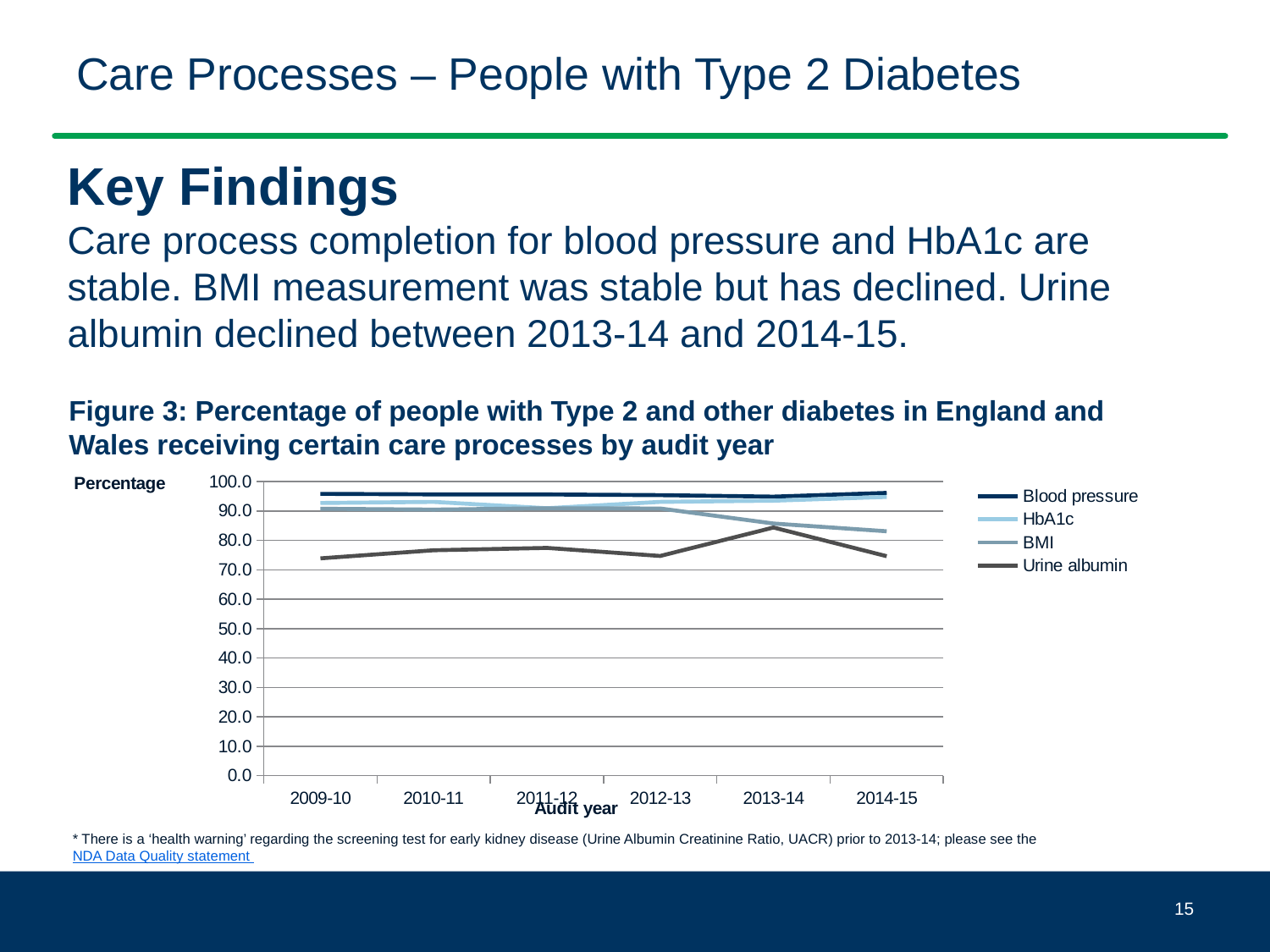
Which care process has the highest percentage in 2009-10? Blood pressure In 2014-15, which is larger: the value for BMI or the value for Urine albumin? BMI Is the value for Urine albumin in 2009-10 greater or less than 80.0? less Does the BMI line rise or fall between 2012-13 and 2014-15? Fall Is the value for BMI in 2014-15 greater or less than 90.0? less What is the title of the x axis in Figure 3? Audit year Which care process has the lowest percentage in 2014-15? Urine albumin Is the value for Urine albumin in 2013-14 greater or less than 80.0? greater How many series does the legend of Figure 3 list? 4 What kind of chart is Figure 3? Line chart How many audit years are shown on the x axis of Figure 3? 6